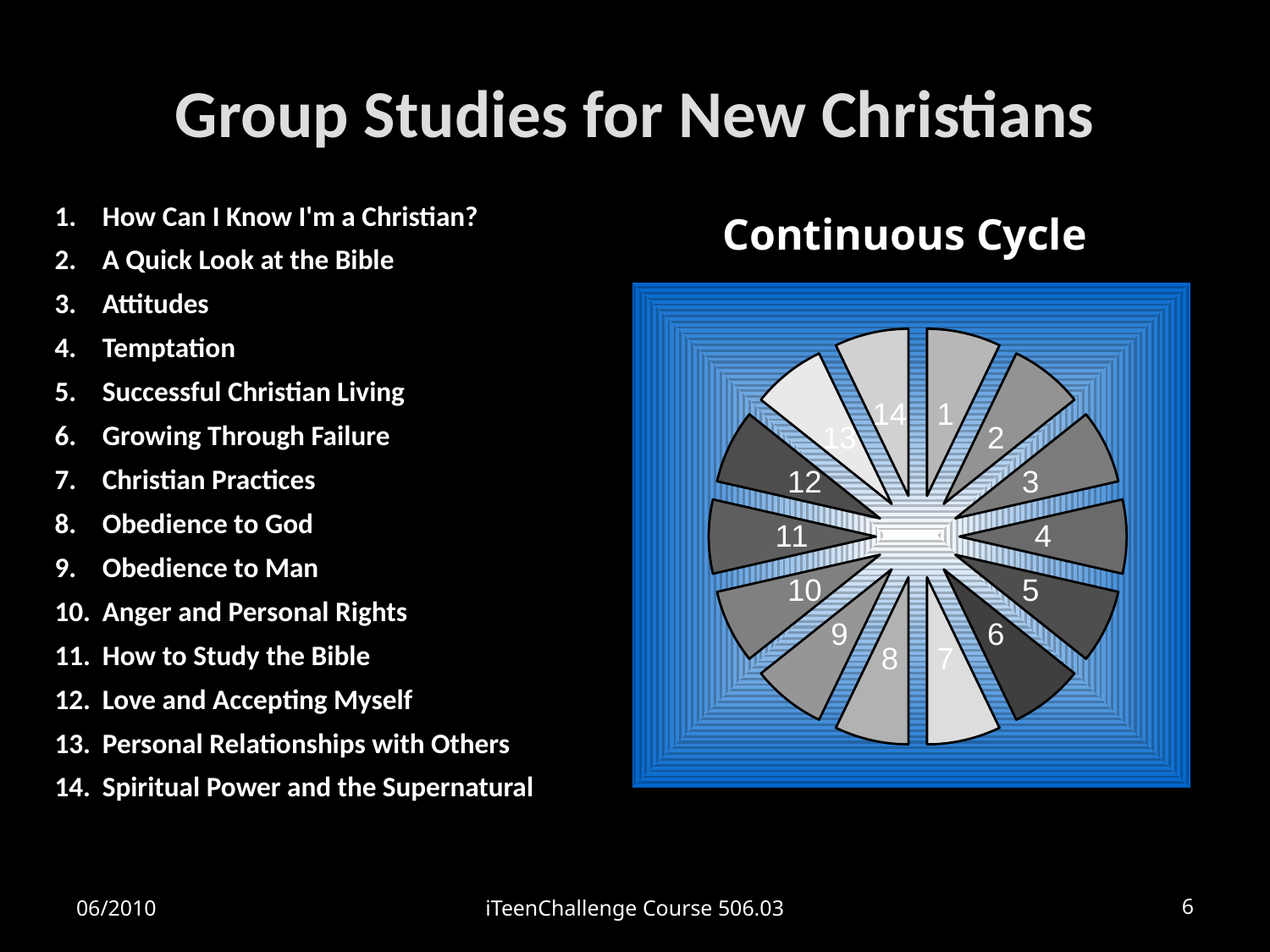
What kind of chart is shown on the slide? pie chart Which slice label sits directly to the right of the centre of the pie chart? 4 What is the title shown above the pie chart? Continuous Cycle What colour is the background square behind the pie chart? blue What is the highest number labelled on a slice of the pie chart? 14 What is the lowest number labelled on a slice of the pie chart? 1 Which slice is immediately clockwise from slice 14 in the pie chart? 1 Do the slice numbers increase clockwise or counter-clockwise around the pie chart? clockwise Which slice label sits directly to the left of the centre of the pie chart? 11 How many slices does the pie chart contain? 14